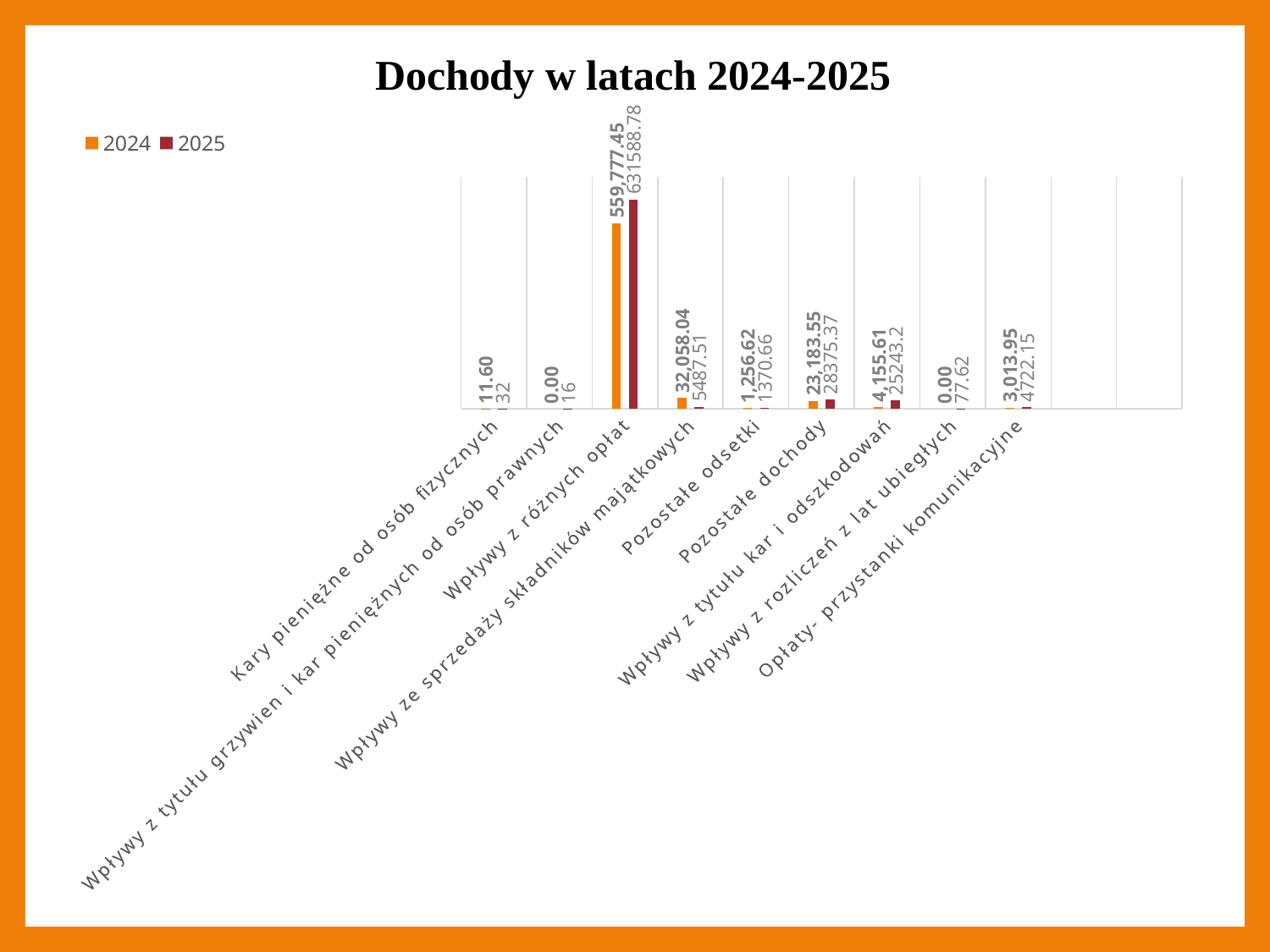
How many categories are shown on the x axis? 9 What is the 2025 value for Wpływy z tytułu kar i odszkodowań? 25243.2 What is the 2025 value for Wpływy z różnych opłat? 631588.78 What type of chart is shown? Bar chart What is the difference between the 2025 and 2024 values for Pozostałe odsetki? 114.04 What is the 2025 value for Wpływy z rozliczeń z lat ubiegłych? 77.62 How many series does the legend list? 2 What is the 2024 value for Pozostałe dochody? 23,183.55 What is the 2024 value for Wpływy z różnych opłat? 559,777.45 Which category has the lowest 2025 value? Wpływy z tytułu grzywien i kar pieniężnych od osób prawnych Which is larger for Wpływy ze sprzedaży składników majątkowych, the 2024 value or the 2025 value? 2024 Which category has the highest 2025 value? Wpływy z różnych opłat